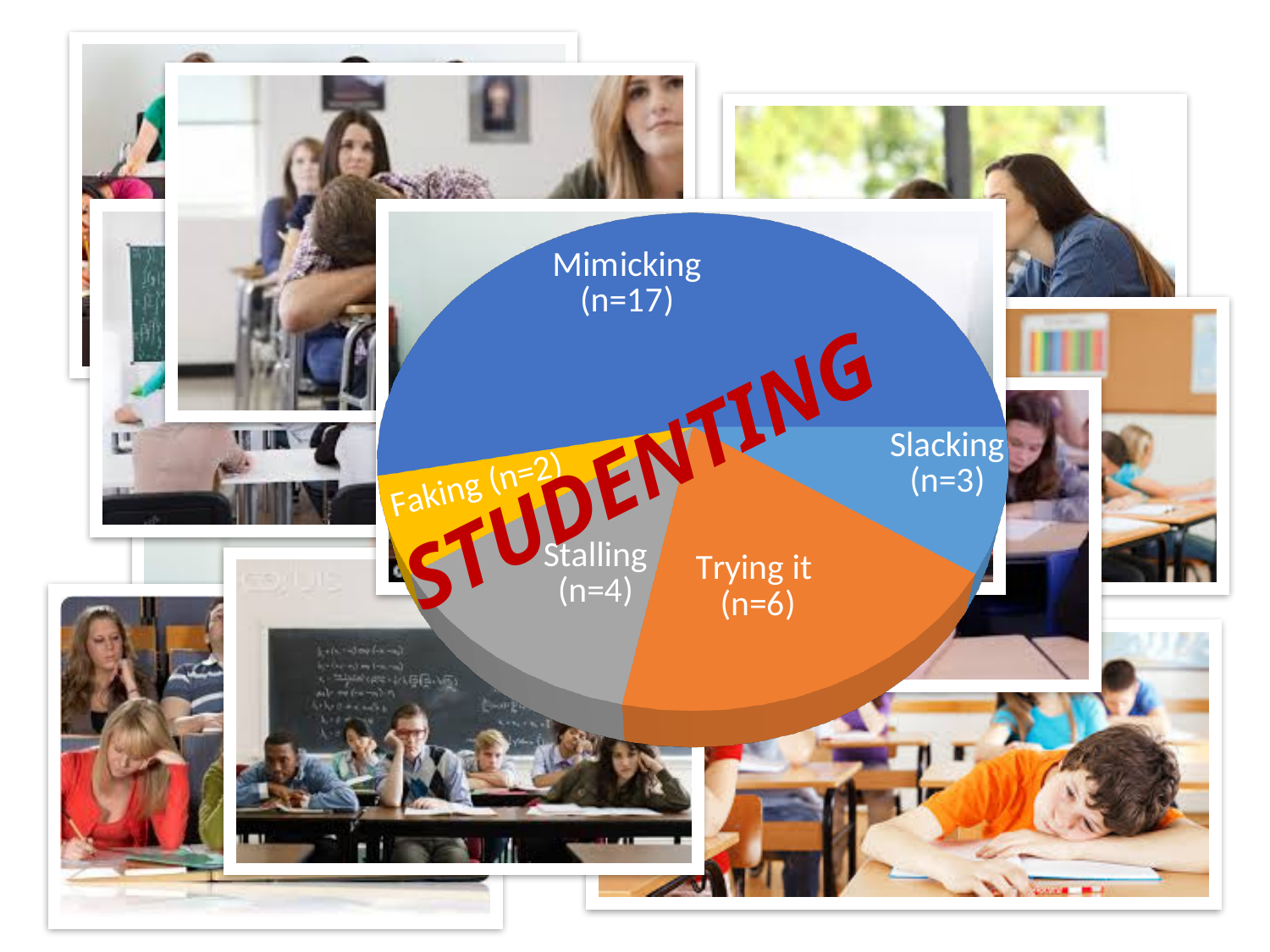
What is the difference in n between Trying it and Stalling? 2 Which category has the largest slice of the pie chart? Mimicking Which category has the smallest slice of the pie chart? Faking How many more students are in the Mimicking category than in the Slacking category? 14 How many categories are shown in the pie chart? 5 What is the n value for the Stalling slice? 4 Which has a larger n, Trying it or Stalling? Trying it What type of chart is shown on the slide? Pie chart What is the n value for the Mimicking slice of the pie chart? 17 What is the n value for the Slacking slice? 3 What is the total n across all slices of the pie chart? 32 What is the n value for the Trying it slice? 6